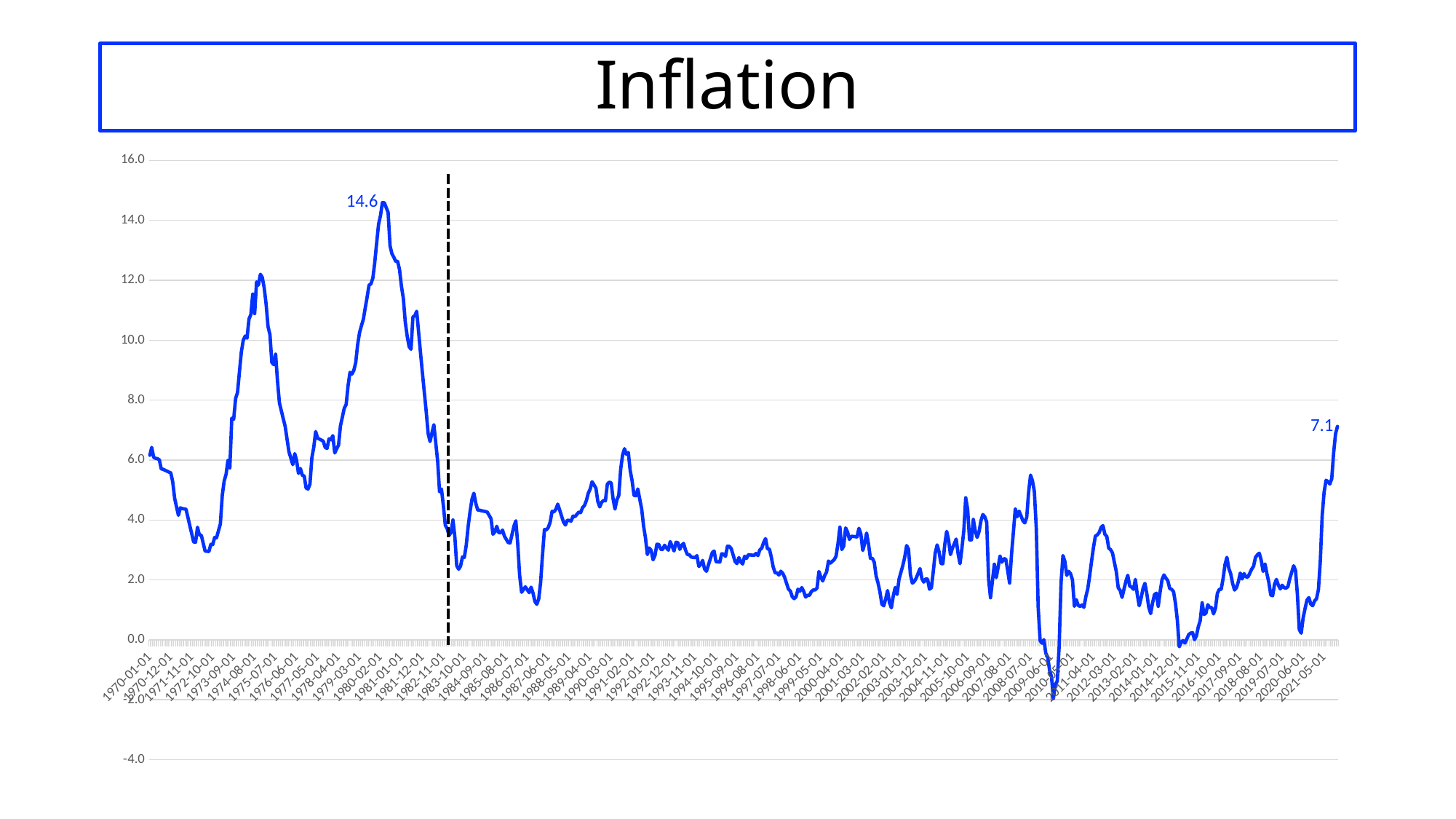
Does the inflation line rise or fall between 1981 and 1983? fall What is the difference between the labelled peak value 14.6 and the labelled end value 7.1? 7.5 What is the highest value shown on the vertical axis? 16.0 What kind of chart is shown on the slide? line chart Is the inflation value at 1970-01-01 greater or less than 8.0? less Is the inflation value at 1974-08-01 greater or less than 10.0? greater Which is larger: the labelled peak around 1980 or the labelled value at the end of the series? the peak around 1980 (14.6) What is the highest value labelled on the inflation line? 14.6 Is the lowest point of the line, around 2009, greater or less than 2.0? less What is the title of the chart? Inflation What is the value labelled at the right-hand end of the inflation line? 7.1